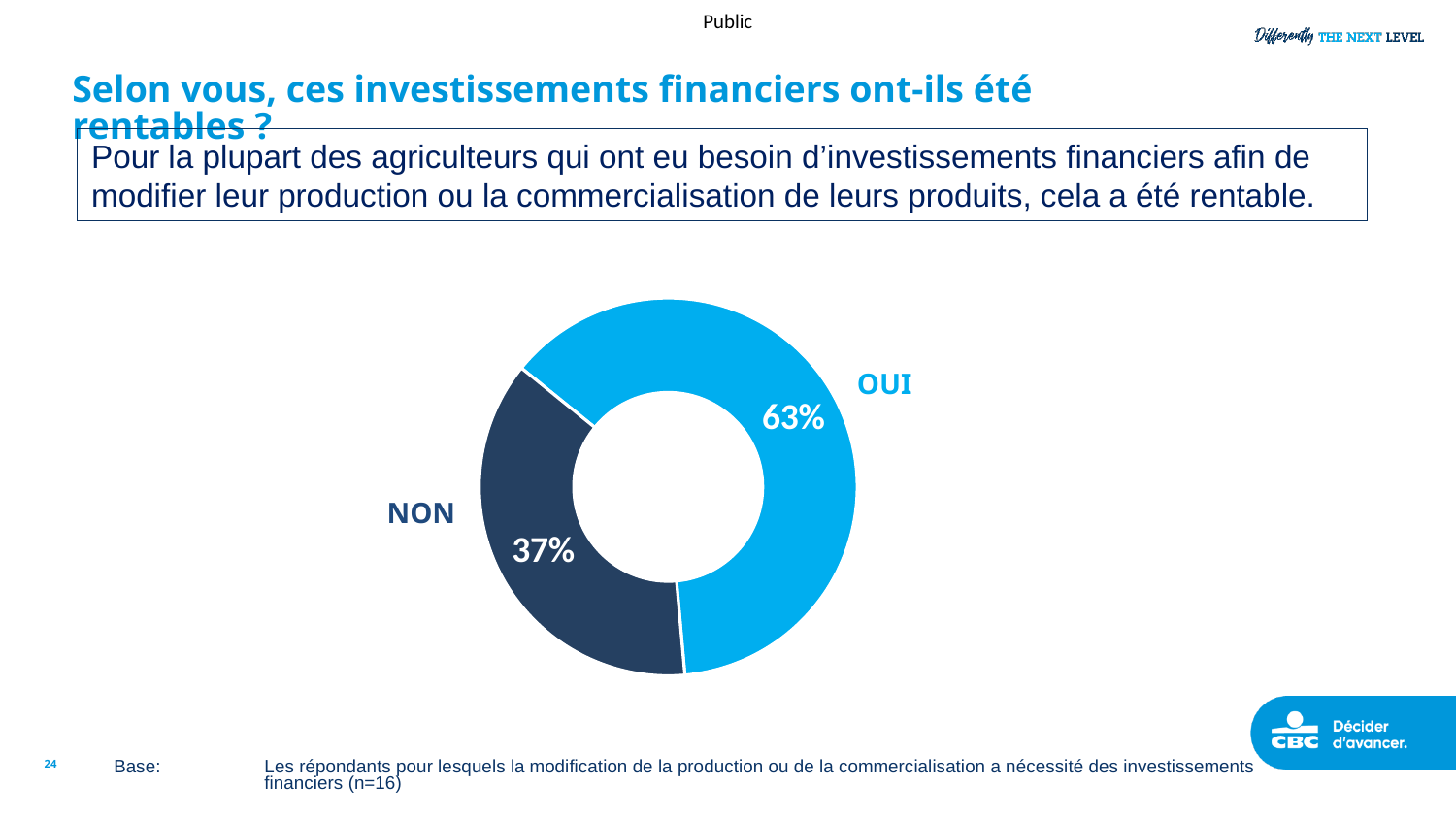
How many categories are shown in the chart? 2 What percentage of respondents answered NON? 37% Which is larger, the share for OUI or the share for NON? OUI What is the difference in percentage points between OUI and NON? 26 Which response has the largest share of the pie? OUI What colour is the NON slice? Dark navy blue Which response has the smallest share of the pie? NON What share of the pie does the OUI slice represent? 63% What kind of chart is shown on the slide? Pie chart (donut) What is the sample size (n) stated in the base note below the chart? n=16 What percentage of respondents answered OUI? 63%